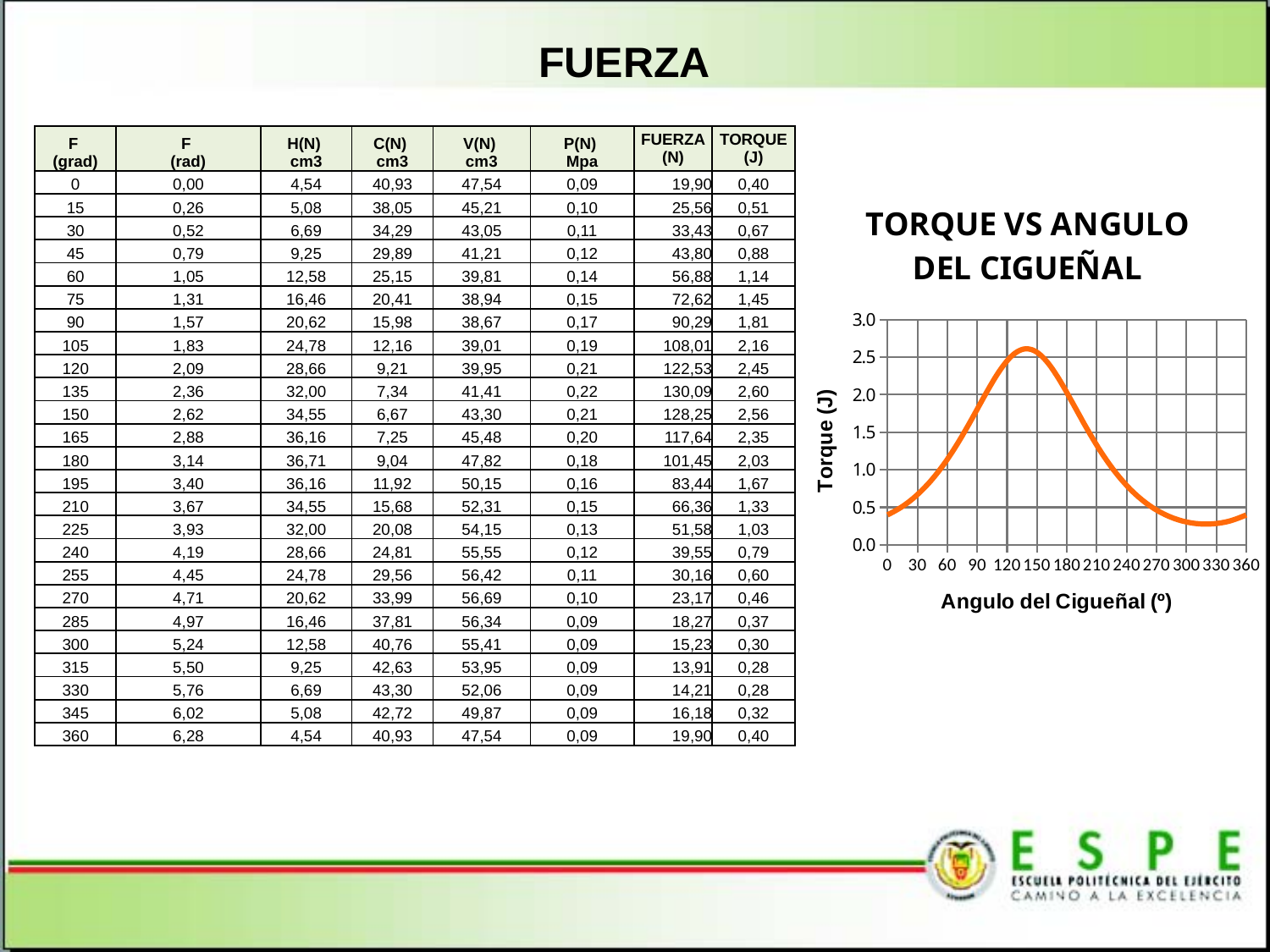
In the TORQUE VS ANGULO DEL CIGUEÑAL chart, does the torque rise or fall as the angle goes from 180 to 300 degrees? fall In the TORQUE VS ANGULO DEL CIGUEÑAL chart, does the torque rise or fall as the angle goes from 0 to 150 degrees? rise In the TORQUE VS ANGULO DEL CIGUEÑAL chart, is the torque at 90 degrees greater or less than 1.5? greater What is the label of the vertical axis in the TORQUE VS ANGULO DEL CIGUEÑAL chart? Torque (J) In the TORQUE VS ANGULO DEL CIGUEÑAL chart, is the torque at 150 degrees greater or less than 2.0? greater What is the label of the horizontal axis in the TORQUE VS ANGULO DEL CIGUEÑAL chart? Angulo del Cigueñal (º) In the TORQUE VS ANGULO DEL CIGUEÑAL chart, which is larger: the torque at 120 degrees or the torque at 270 degrees? 120 degrees What type of chart is shown under the title "TORQUE VS ANGULO DEL CIGUEÑAL"? Line chart In the TORQUE VS ANGULO DEL CIGUEÑAL chart, is the torque at 240 degrees greater or less than 1.0? less